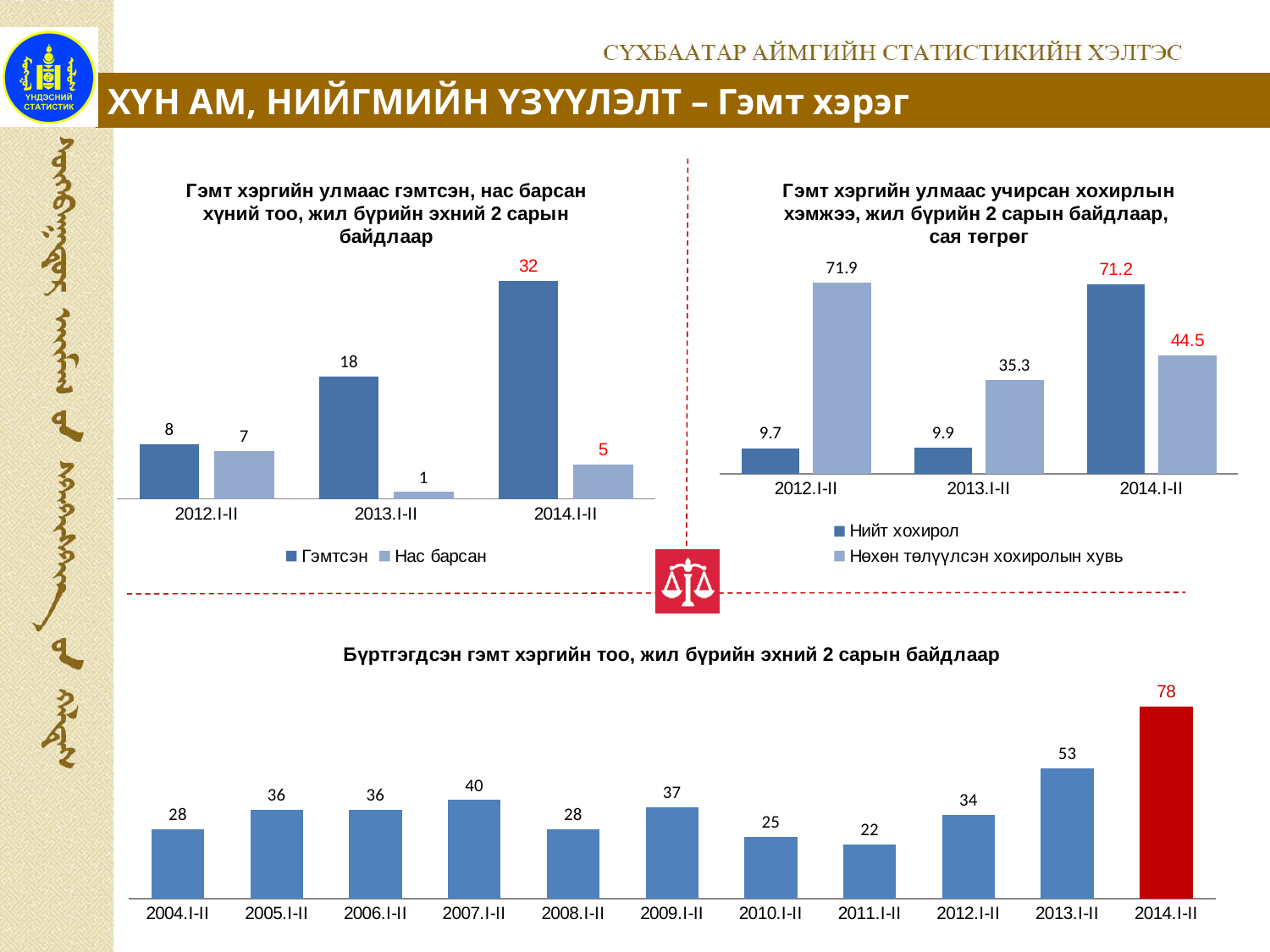
How many categories are shown on the x axis of the bottom chart? 11 In the bottom chart, what is the difference between the values for 2014.I-II and 2013.I-II? 25 In the top-left chart, what is the value for Гэмтсэн in 2014.I-II? 32 In the bottom chart, what is the value for 2011.I-II? 22 In the top-right chart, what is the value for Нөхөн төлүүлсэн хохиролын хувь in 2013.I-II? 35.3 In the top-left chart, what is the value for Нас барсан in 2013.I-II? 1 In the top-right chart, which is larger in 2012.I-II: Нийт хохирол or Нөхөн төлүүлсэн хохиролын хувь? Нөхөн төлүүлсэн хохиролын хувь In the top-left chart, what is the difference between Гэмтсэн and Нас барсан in 2012.I-II? 1 How many series does the legend of the top-left chart list? 2 In the top-right chart, what is the value for Нийт хохирол in 2014.I-II? 71.2 In the top-right chart, which year has the highest value for Нөхөн төлүүлсэн хохиролын хувь? 2012.I-II In the bottom chart, which year has the highest value? 2014.I-II